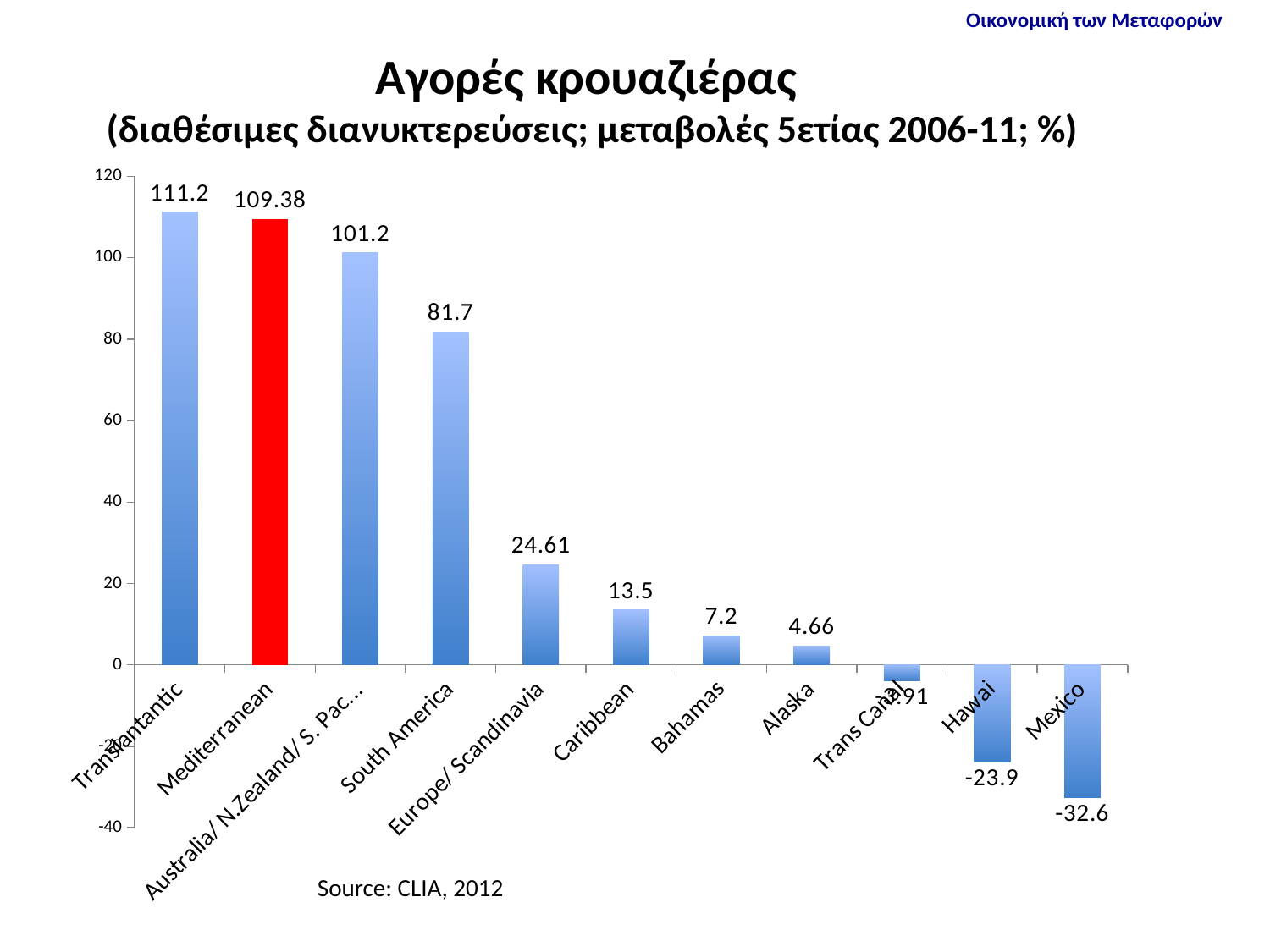
What is the value for Mediterranean? 109.38 What kind of chart is shown on the slide? bar chart What is the difference between the values for Caribbean and Bahamas? 6.3 How many categories are shown in the chart? 11 Is the value for Hawai greater or less than -20? less Which bar is coloured red instead of blue? Mediterranean What is the value for South America? 81.7 What is the value for Mexico? -32.6 Which category has the highest value? Transatlantic Which is larger, the value for Europe/ Scandinavia or the value for Caribbean? Europe/ Scandinavia Which category has the lowest value? Mexico What is the value for Transatlantic? 111.2